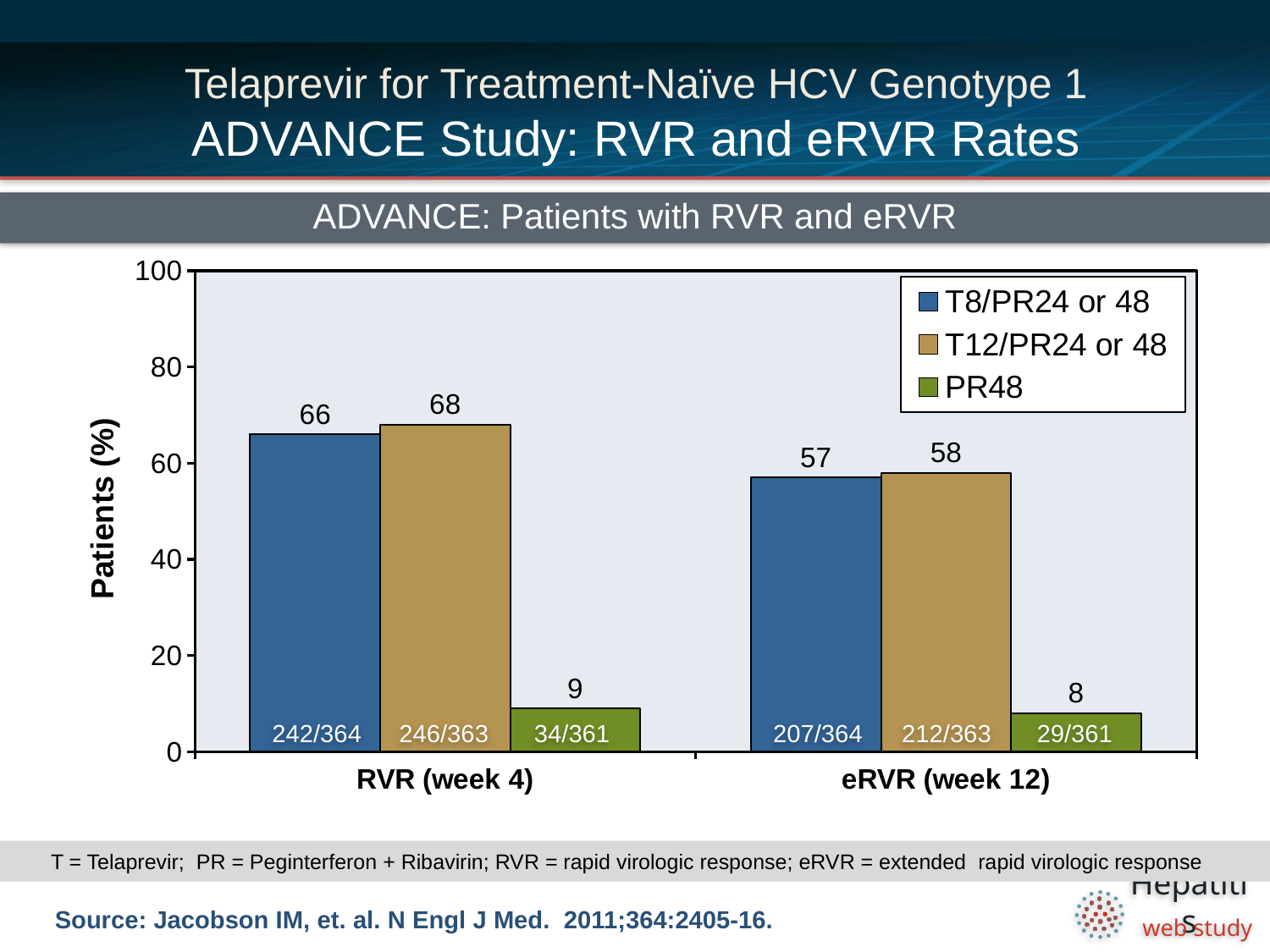
What is the value for T12/PR24 or 48 in the eRVR (week 12) group? 58 What is the label of the y axis? Patients (%) How many series does the legend list? 3 Which series has the lowest value in the RVR (week 4) group? PR48 Which is larger: the T8/PR24 or 48 value for RVR (week 4) or the T8/PR24 or 48 value for eRVR (week 12)? RVR (week 4) What is the difference between the T12/PR24 or 48 value and the PR48 value in the RVR (week 4) group? 59 What is the value for PR48 in the eRVR (week 12) group? 8 What is the value for T8/PR24 or 48 in the RVR (week 4) group? 66 What kind of chart is shown on the slide? Bar chart Which series has the highest value in the eRVR (week 12) group? T12/PR24 or 48 How many categories are shown on the x axis? 2 Is the value for T12/PR24 or 48 in the RVR (week 4) group greater or less than 60? greater